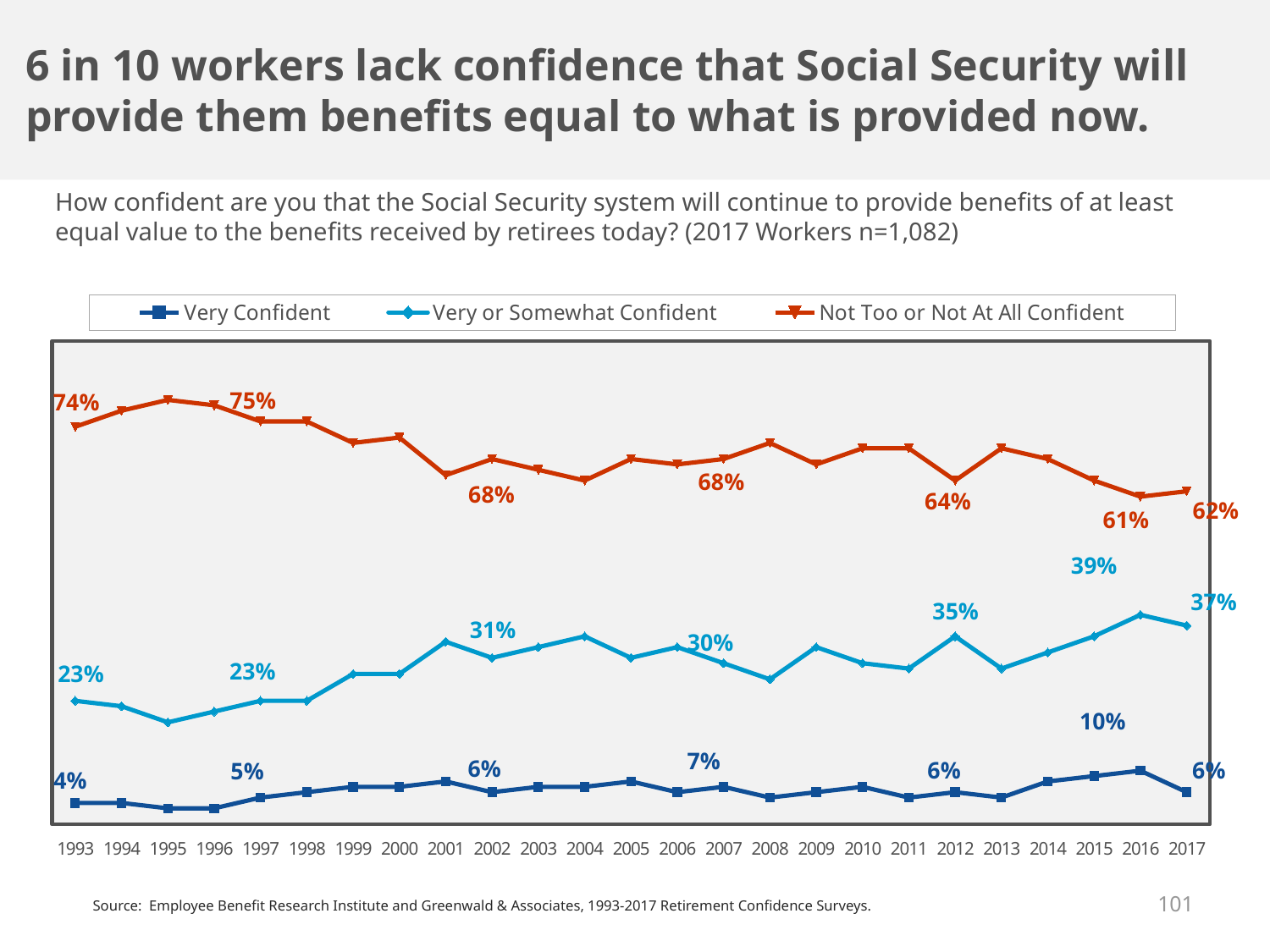
What is the value for Very or Somewhat Confident in 1993? 23% What is the value for Very Confident in 2017? 6% What is the value for Very or Somewhat Confident in 2017? 37% Which series has the highest value in 2017? Not Too or Not At All Confident What kind of chart is shown on the slide? Line chart What is the value for Not Too or Not At All Confident in 2017? 62% How many series does the legend list? 3 In 2017, what is the difference between Not Too or Not At All Confident and Very or Somewhat Confident? 25 percentage points What is the value for Not Too or Not At All Confident in 1993? 74% Is the Not Too or Not At All Confident value larger in 1993 or in 2017? 1993 How many years are shown along the x axis? 25 Does the Not Too or Not At All Confident line generally rise or fall from 1993 to 2017? Fall